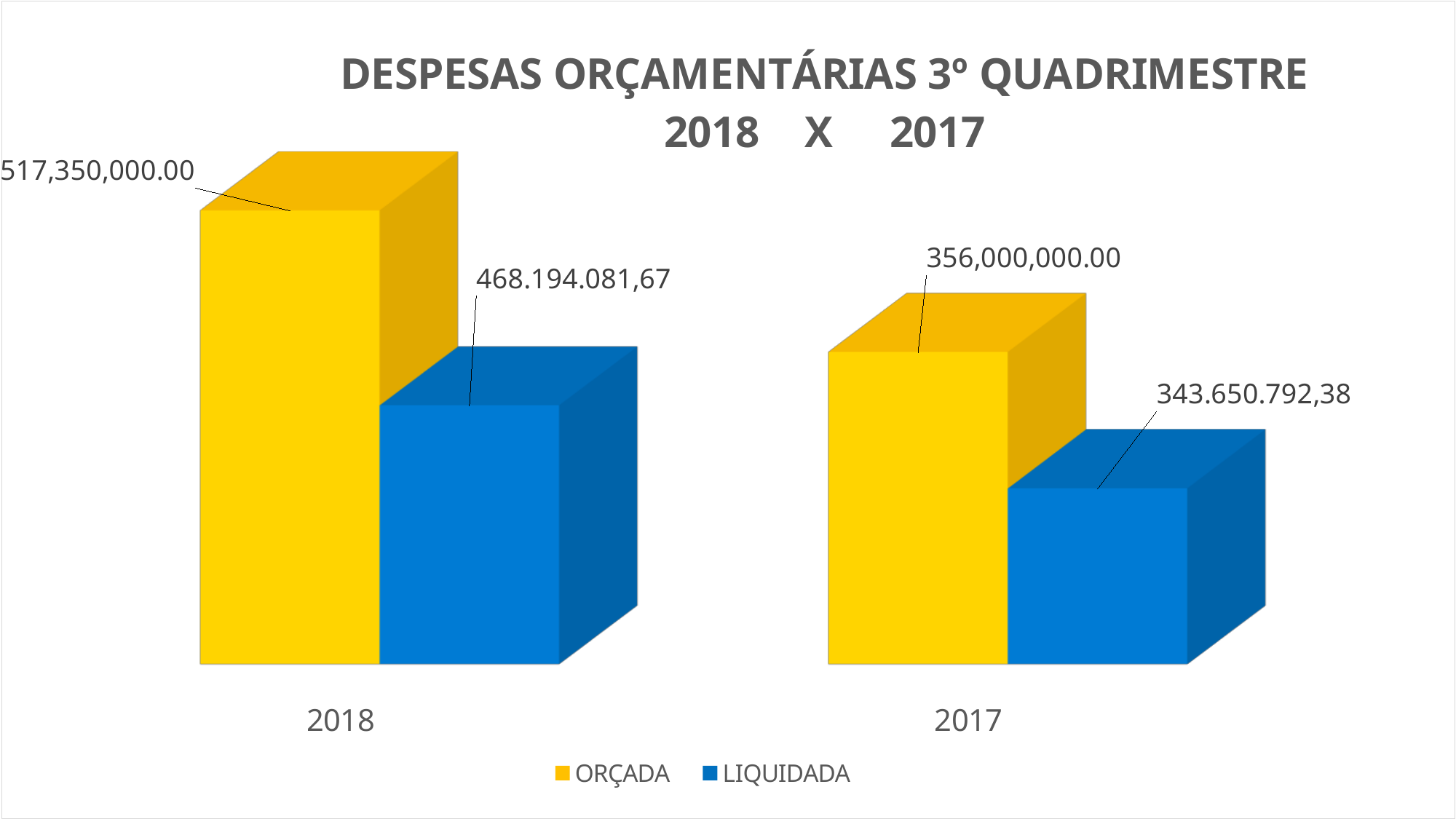
Which colour represents the LIQUIDADA series? Blue What is the LIQUIDADA value for 2017? 343.650.792,38 Which year has the lowest LIQUIDADA value? 2017 What is the ORÇADA value for 2017? 356,000,000.00 How many series does the legend list? 2 What kind of chart is shown on the slide? Bar chart What is the ORÇADA value for 2018? 517,350,000.00 How many years are shown on the x axis? 2 Which is larger for 2018, ORÇADA or LIQUIDADA? ORÇADA What is the LIQUIDADA value for 2018? 468.194.081,67 What is the difference between the ORÇADA values for 2018 and 2017? 161,350,000.00 Which year has the highest ORÇADA value? 2018